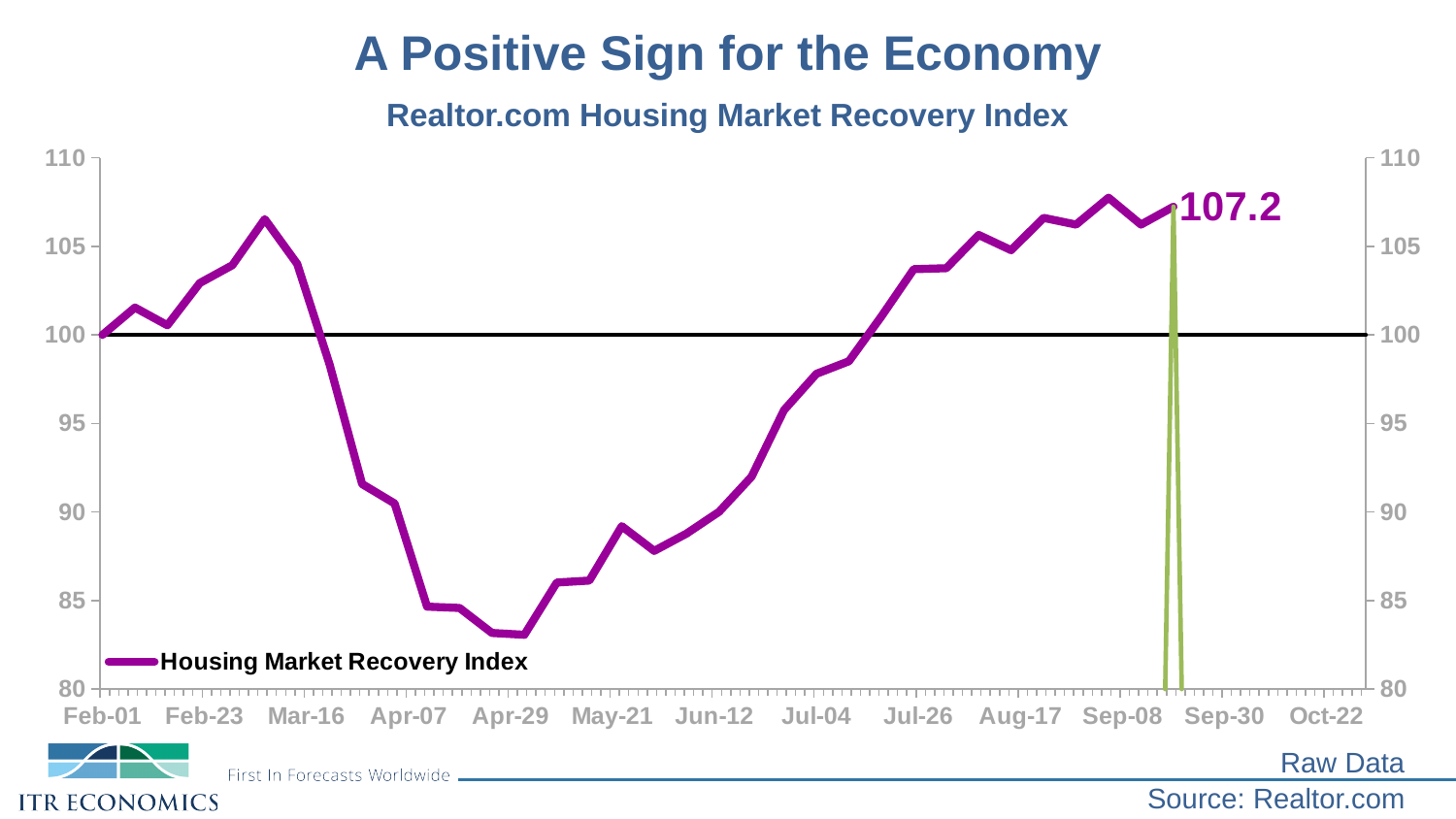
Is the value for Jun-12 greater or less than 95? less How many labels are shown on the x axis? 13 What kind of chart is shown on the slide? line chart Is the value for Apr-29 greater or less than 85? less What is the chart's title? Realtor.com Housing Market Recovery Index Is the value for Jul-04 greater or less than 95? greater Does the line rise or fall between Feb-23 and Apr-29? fall What is the name of the series shown in the legend? Housing Market Recovery Index How many series does the legend list? 1 Which is larger, the value at Feb-23 or the value at Apr-07? Feb-23 What is the value of the Housing Market Recovery Index at the last labelled point on the line? 107.2